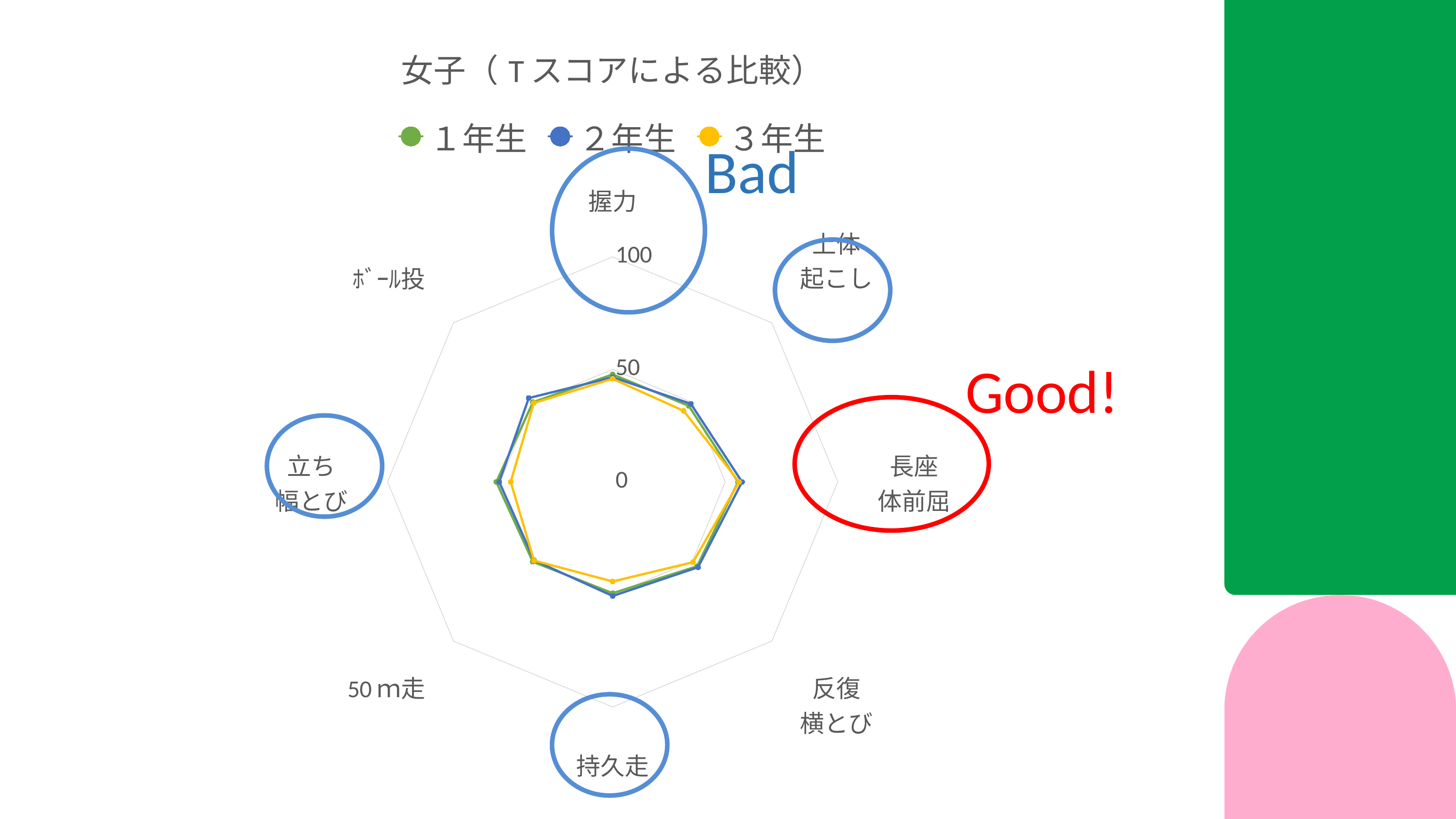
Is the value for 持久走 for １年生 greater or less than 100? less Is the value for 長座体前屈 for ３年生 greater or less than 100? less How many categories (axes) does the radar chart have? 8 Which series is drawn in yellow? ３年生 What kind of chart is shown on the slide? radar chart What is the maximum value shown on the radar chart's axis scale? 100 How many series does the legend list? 3 Is the value for 立ち幅とび for ２年生 greater or less than 0? greater What is the title of the chart? 女子（Ｔスコアによる比較）